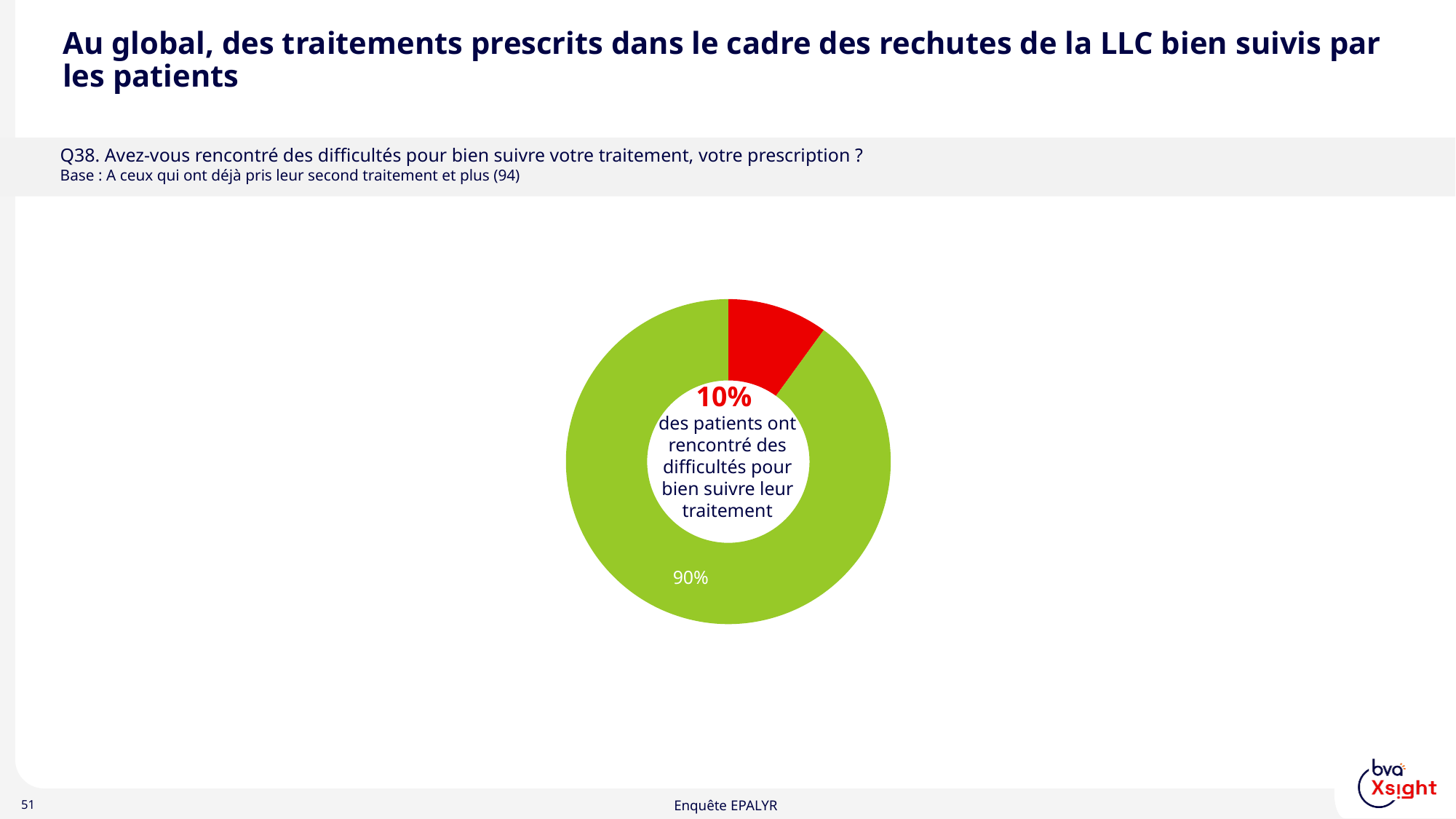
How many slices does the donut chart have? 2 What percentage is shown on the green slice of the donut chart? 90% What kind of chart is shown on the slide? pie chart (donut) What colour is the slice representing patients who encountered difficulties following their treatment? red What percentage is shown on the red slice of the donut chart? 10% Which slice is larger, the green one or the red one? the green one What is the total of the two slice values shown on the donut chart? 100% Which slice of the donut chart has the smallest value? the red slice (10%) What is the base (number of respondents) stated for the chart's question Q38? 94 Which slice of the donut chart has the largest value? the green slice (90%) What is the difference between the green slice's value and the red slice's value? 80 percentage points What share of patients encountered difficulties following their treatment, according to the chart? 10%